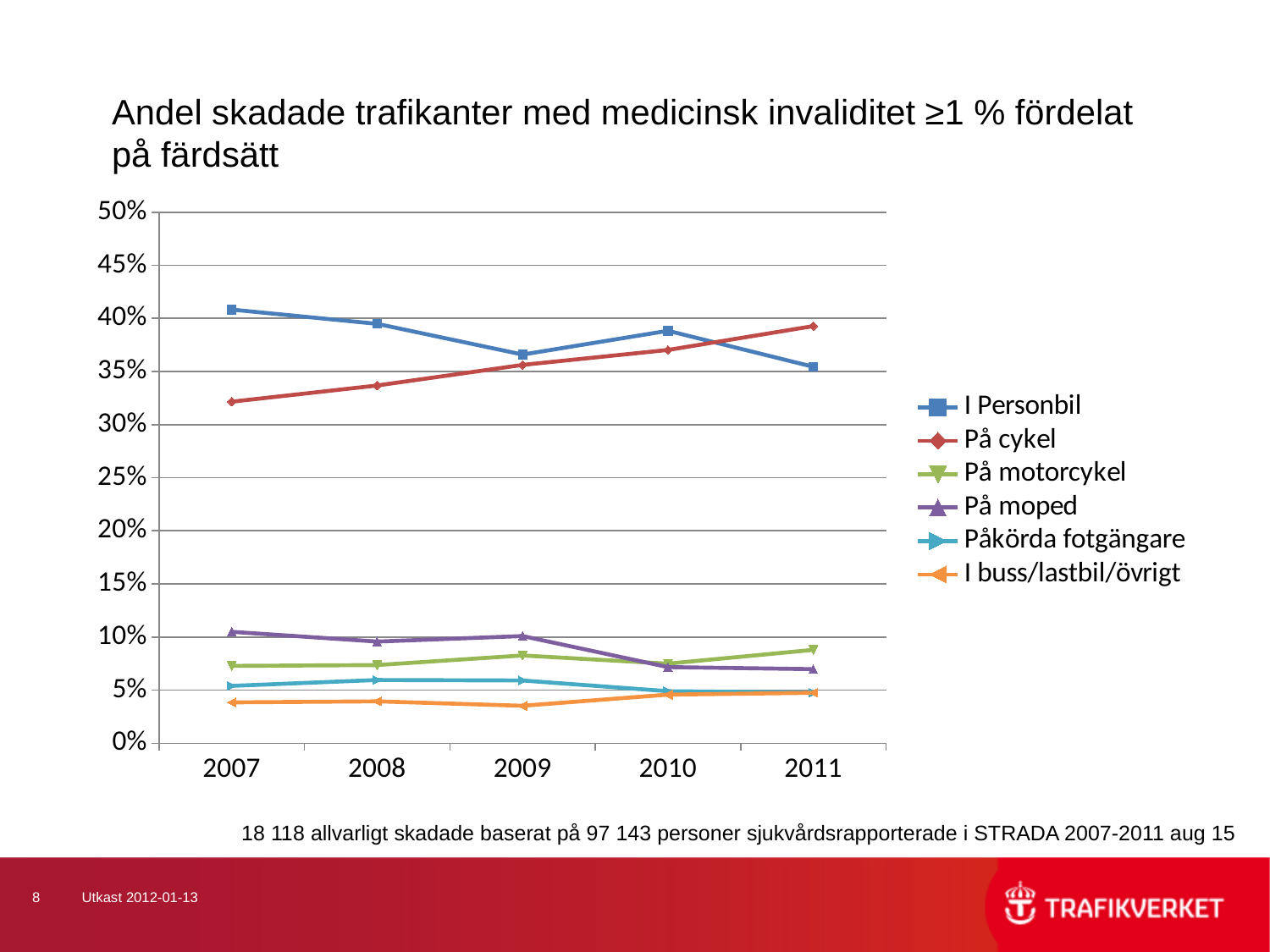
What is the title of the chart? Andel skadade trafikanter med medicinsk invaliditet ≥1 % fördelat på färdsätt Does the value for I Personbil rise or fall overall from 2007 to 2011? fall Is the value for På moped in 2010 greater or less than 10%? less How many series does the legend list? 6 Which series has the lowest value in 2009? I buss/lastbil/övrigt In 2011, which is larger: the value for På cykel or the value for I Personbil? På cykel How many years are shown on the x axis? 5 What kind of chart is shown on the slide? line chart In 2007, which is larger: the value for På moped or the value for På motorcykel? På moped Is the value for På cykel in 2007 greater or less than 35%? less Does the value for På cykel rise or fall from 2007 to 2011? rise Which series has the highest value in 2007? I Personbil